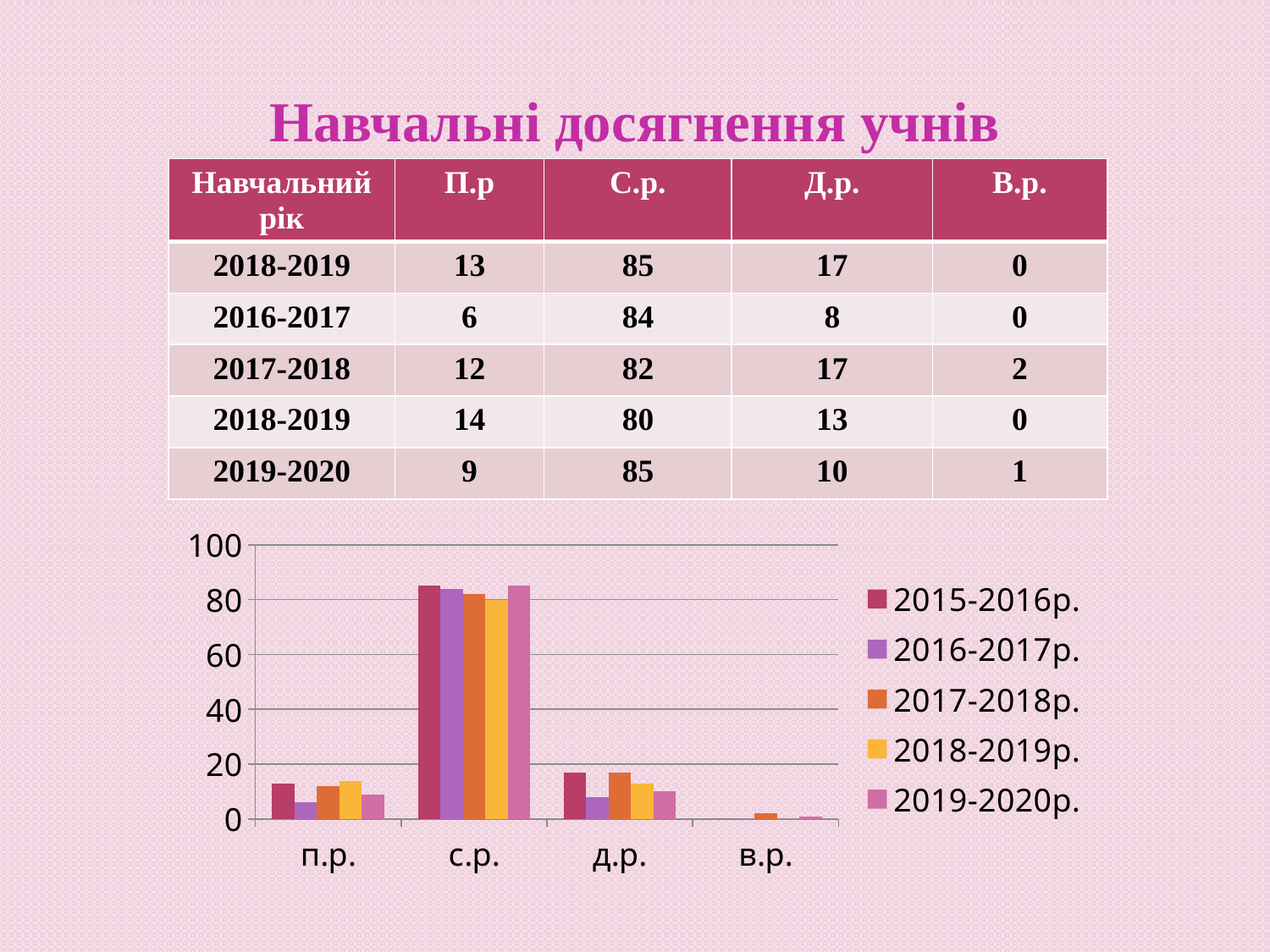
Which series is listed last in the chart legend? 2019-2020р. Is the value for с.р. in the 2016-2017р. series greater or less than 60? greater For the 2019-2020р. series, which is larger: the с.р. bar or the д.р. bar? с.р. What is the highest value shown on the chart's vertical axis? 100 What kind of chart is shown on the slide? bar chart Is the value for д.р. in the 2017-2018р. series greater or less than 40? less Is the value for п.р. in the 2015-2016р. series greater or less than 20? less In the п.р. category, which is larger: the 2018-2019р. bar or the 2016-2017р. bar? 2018-2019р. How many series does the chart legend list? 5 How many categories are shown on the x axis of the chart? 4 Which category has the tallest bars in the chart? с.р. Which category has the shortest bars in the chart? в.р.